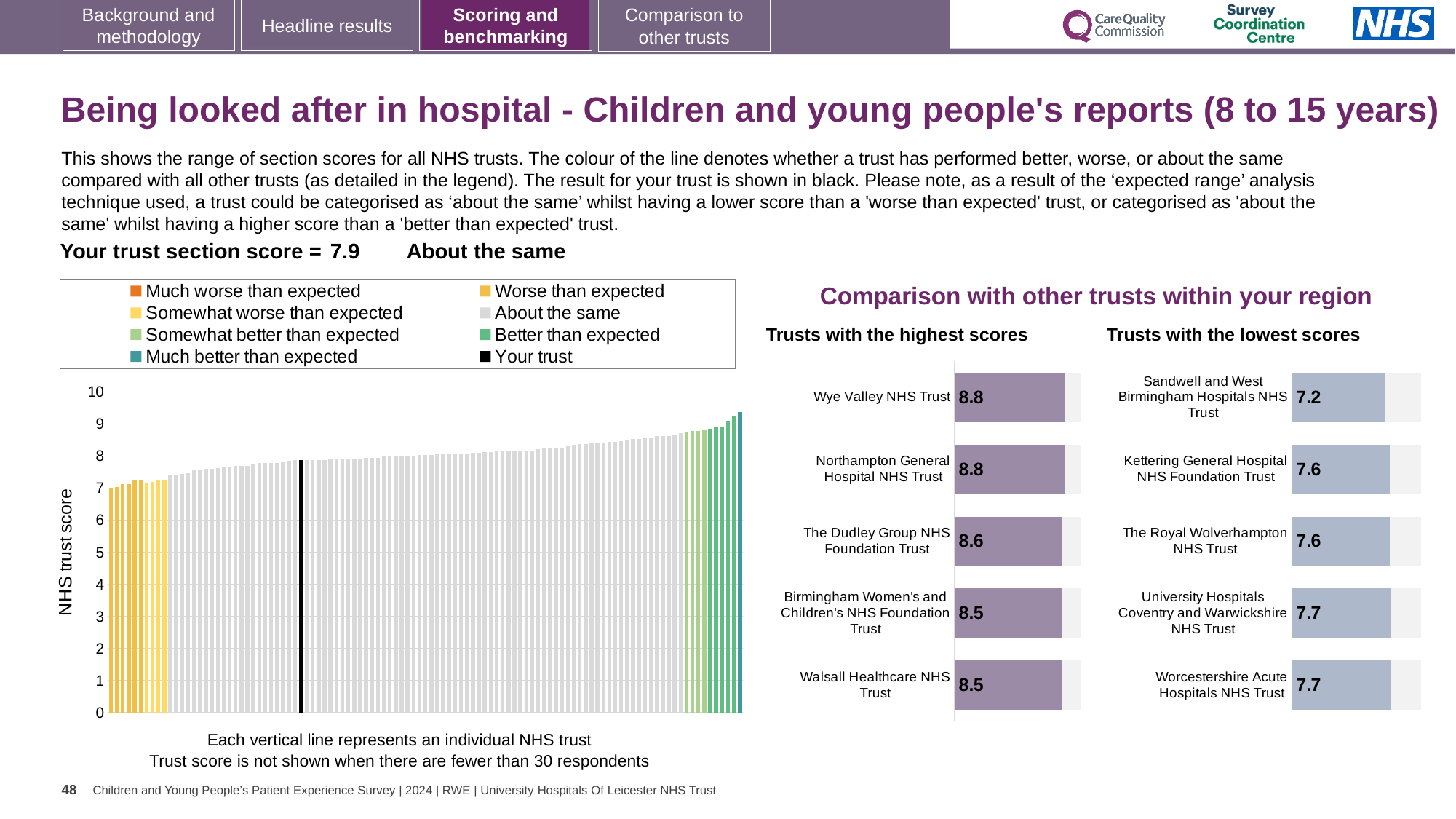
In the 'Trusts with the lowest scores' chart, what is the score for Sandwell and West Birmingham Hospitals NHS Trust? 7.2 In the large chart on the left, do the trust scores rise or fall from left to right? Rise In the large chart on the left, is the value of the tallest bar at the far right greater or less than 9? greater In the 'Trusts with the highest scores' chart, what is the score for Wye Valley NHS Trust? 8.8 How many trusts are listed in the 'Trusts with the lowest scores' chart? 5 In the 'Trusts with the highest scores' chart, what is the score for The Dudley Group NHS Foundation Trust? 8.6 In the 'Trusts with the highest scores' chart, which has the larger score: The Dudley Group NHS Foundation Trust or Birmingham Women's and Children's NHS Foundation Trust? The Dudley Group NHS Foundation Trust In the 'Trusts with the lowest scores' chart, what is the score for Kettering General Hospital NHS Foundation Trust? 7.6 What kind of chart is the large chart on the left with the y-axis labelled 'NHS trust score'? Bar chart How many entries does the legend above the large chart on the left list? 8 In the 'Trusts with the lowest scores' chart, which trust has the lowest score? Sandwell and West Birmingham Hospitals NHS Trust In the 'Trusts with the highest scores' chart, what is the difference between the score for Wye Valley NHS Trust and the score for Walsall Healthcare NHS Trust? 0.3